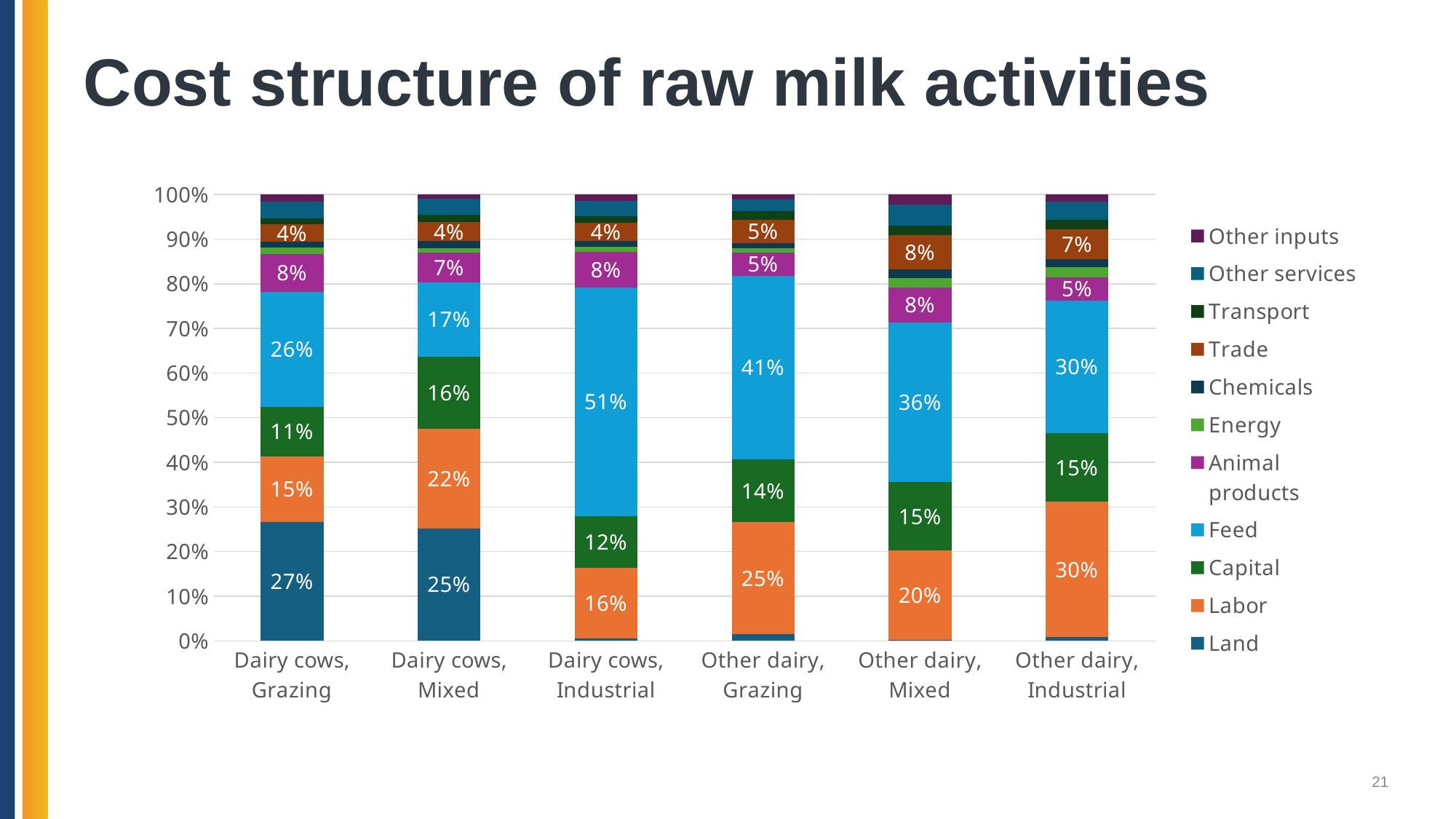
Which category has the highest Feed share? Dairy cows, Industrial What is the Feed share for Dairy cows, Industrial? 51% What is the Capital share for Dairy cows, Mixed? 16% What is the Land share for Dairy cows, Grazing? 27% How many series does the legend list? 11 How many categories are shown on the x axis? 6 Among the labelled Feed values, which category has the lowest Feed share? Dairy cows, Mixed What is the title of the slide? Cost structure of raw milk activities Which is larger: the Labor share for Dairy cows, Mixed or the Labor share for Other dairy, Mixed? Dairy cows, Mixed What kind of chart is shown on the slide? Stacked bar chart What is the Labor share for Other dairy, Industrial? 30% What is the difference between the Feed share for Dairy cows, Industrial and the Feed share for Dairy cows, Grazing? 25%